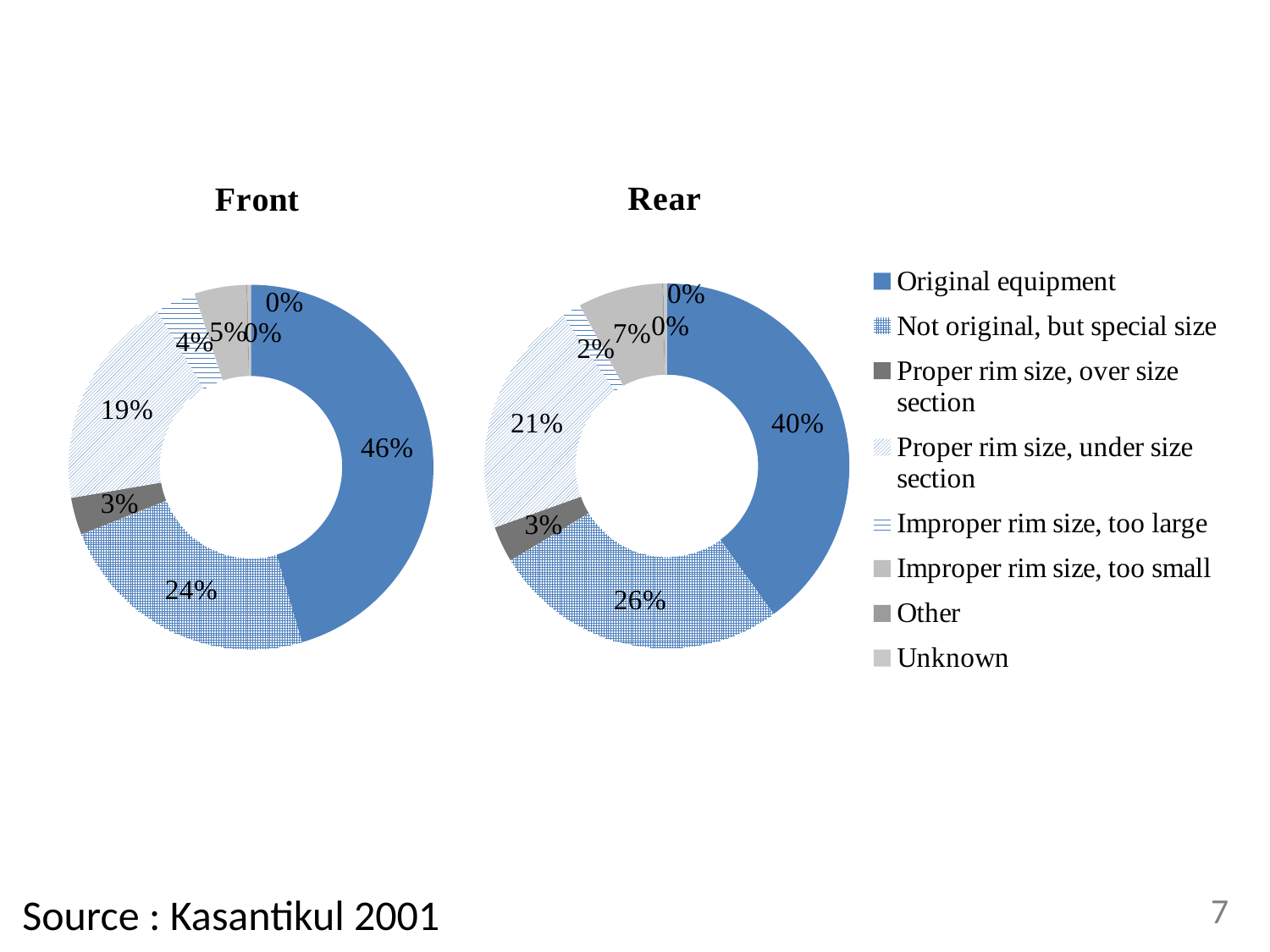
What kind of chart is the Front chart? doughnut chart In the Rear chart, what percentage is Improper rim size, too small? 7% In the Rear chart, what percentage is Original equipment? 40% In the Front chart, what percentage is Original equipment? 46% In the Front chart, which category has the largest share? Original equipment Which is larger: Proper rim size, under size section in the Front chart or in the Rear chart? Rear In the Front chart, what is the difference between Original equipment and Not original, but special size? 22% In the Front chart, what percentage is Not original, but special size? 24% In the Rear chart, what percentage is Proper rim size, under size section? 21% How many categories does the legend list? 8 What is the difference between the Original equipment share in the Front chart and in the Rear chart? 6% In the Rear chart, which category has the largest share? Original equipment